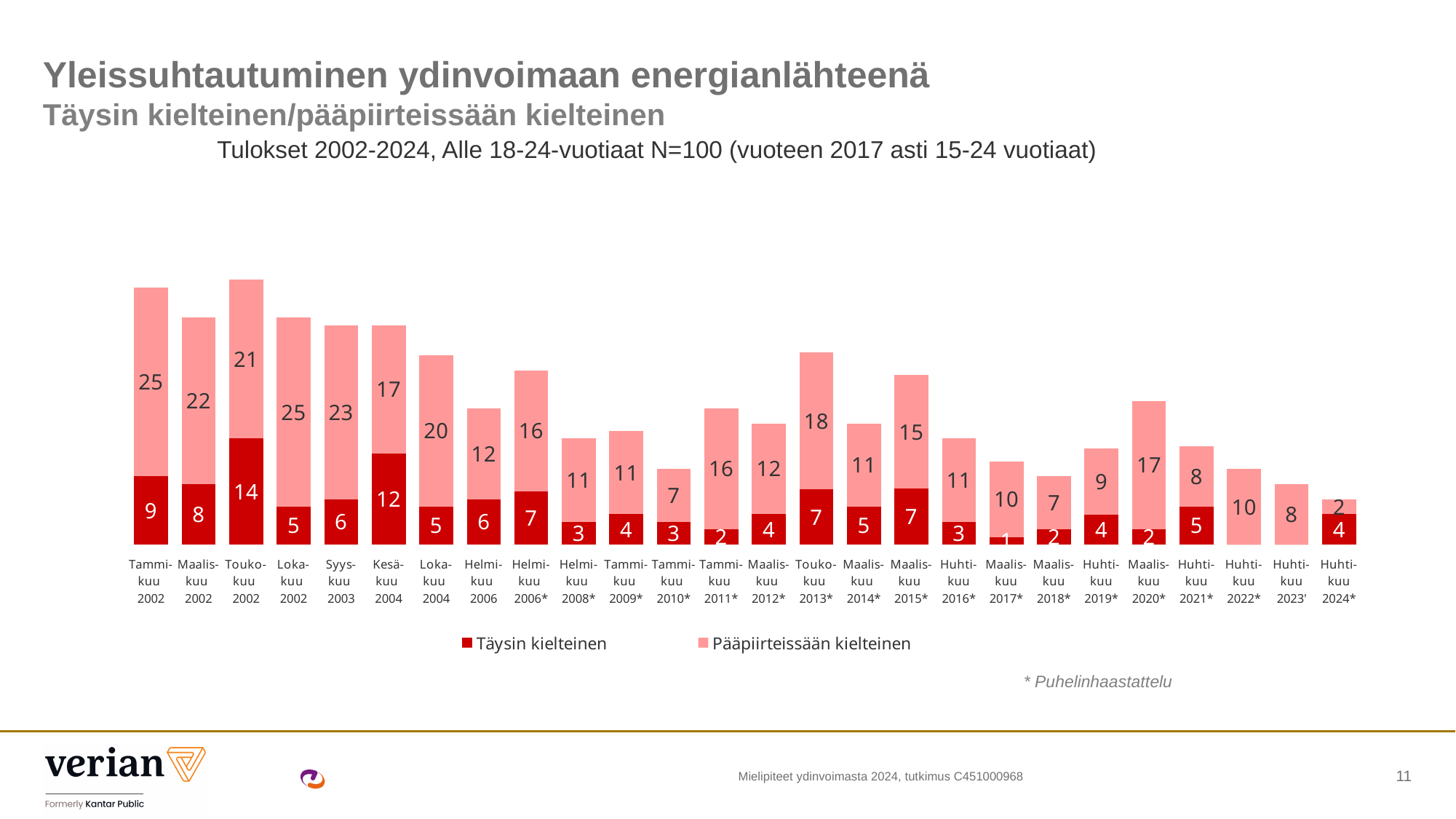
Which category has the lowest value for 'Pääpiirteissään kielteinen'? Huhtikuu 2024* Do the total bar heights generally rise or fall from 2002 to 2024? Fall What is the total of the stacked bar for Huhtikuu 2024*? 6 What is the value of 'Pääpiirteissään kielteinen' for Huhtikuu 2024*? 2 What is the difference between the 'Täysin kielteinen' values for Toukokuu 2002 and Kesäkuu 2004? 2 Which category has the highest value for 'Täysin kielteinen'? Toukokuu 2002 What is the value of 'Täysin kielteinen' for Toukokuu 2002? 14 What is the total of the stacked bar for Toukokuu 2002? 35 Which has the larger 'Pääpiirteissään kielteinen' value, Toukokuu 2013* or Maaliskuu 2015*? Toukokuu 2013* What type of chart is shown on the slide? Stacked bar chart How many series does the legend list? 2 What is the value of 'Pääpiirteissään kielteinen' for Toukokuu 2013*? 18